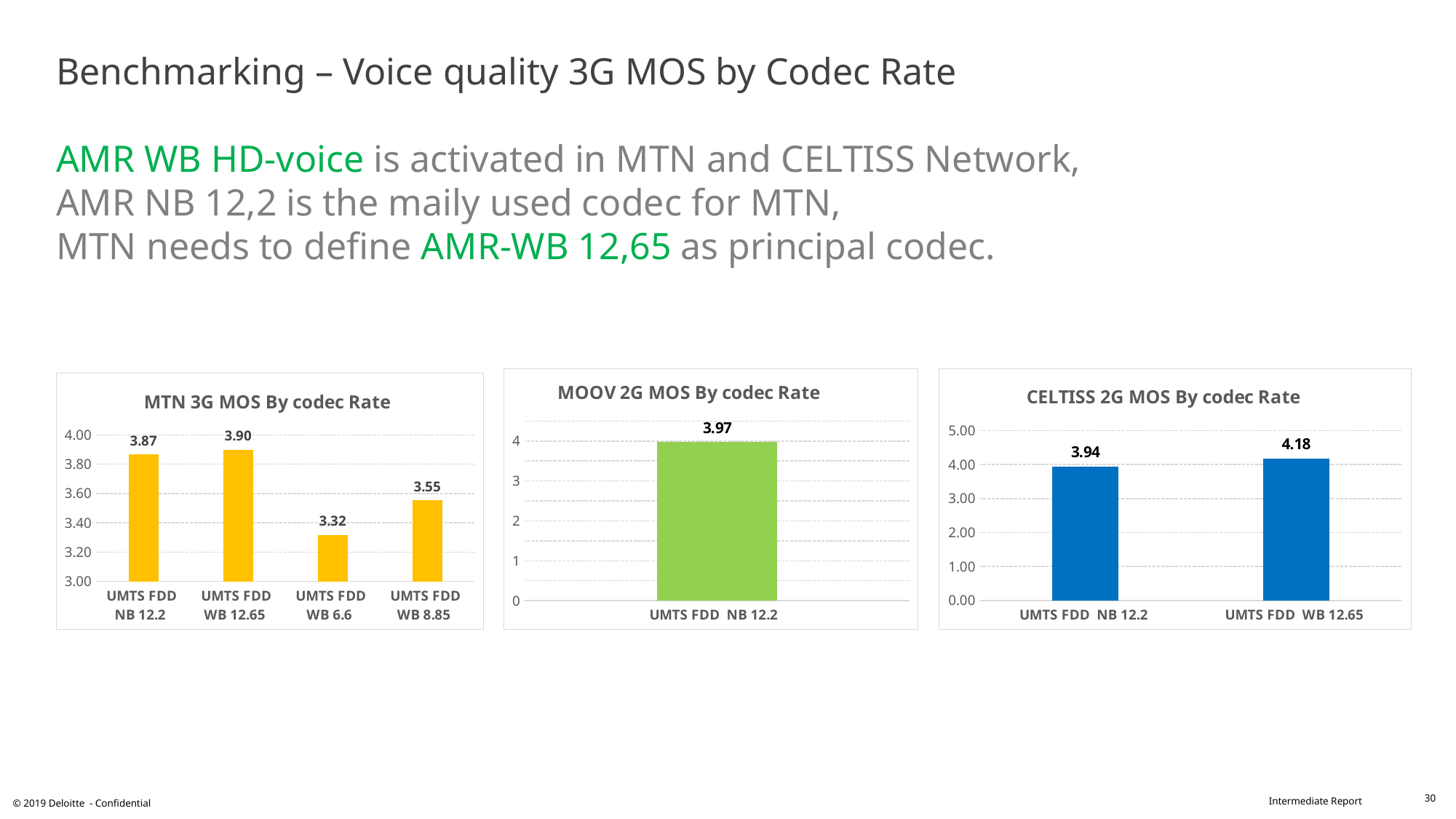
In the 'CELTISS 2G MOS By codec Rate' chart, what is the value for UMTS FDD WB 12.65? 4.18 In the 'MTN 3G MOS By codec Rate' chart, what is the difference between the values for UMTS FDD NB 12.2 and UMTS FDD WB 6.6? 0.55 In the 'MOOV 2G MOS By codec Rate' chart, how many bars are plotted? 1 In the 'MOOV 2G MOS By codec Rate' chart, what is the value for UMTS FDD NB 12.2? 3.97 In the 'MTN 3G MOS By codec Rate' chart, how many categories are shown? 4 In the 'MTN 3G MOS By codec Rate' chart, which category has the lowest value? UMTS FDD WB 6.6 In the 'MTN 3G MOS By codec Rate' chart, what is the value for UMTS FDD WB 12.65? 3.90 In the 'MTN 3G MOS By codec Rate' chart, is the value for UMTS FDD WB 8.85 greater or less than 3.60? less In the 'CELTISS 2G MOS By codec Rate' chart, which is larger, UMTS FDD NB 12.2 or UMTS FDD WB 12.65? UMTS FDD WB 12.65 In the 'MTN 3G MOS By codec Rate' chart, which category has the highest value? UMTS FDD WB 12.65 In the 'CELTISS 2G MOS By codec Rate' chart, what is the difference between UMTS FDD WB 12.65 and UMTS FDD NB 12.2? 0.24 What type of chart is the 'CELTISS 2G MOS By codec Rate' chart? Bar chart